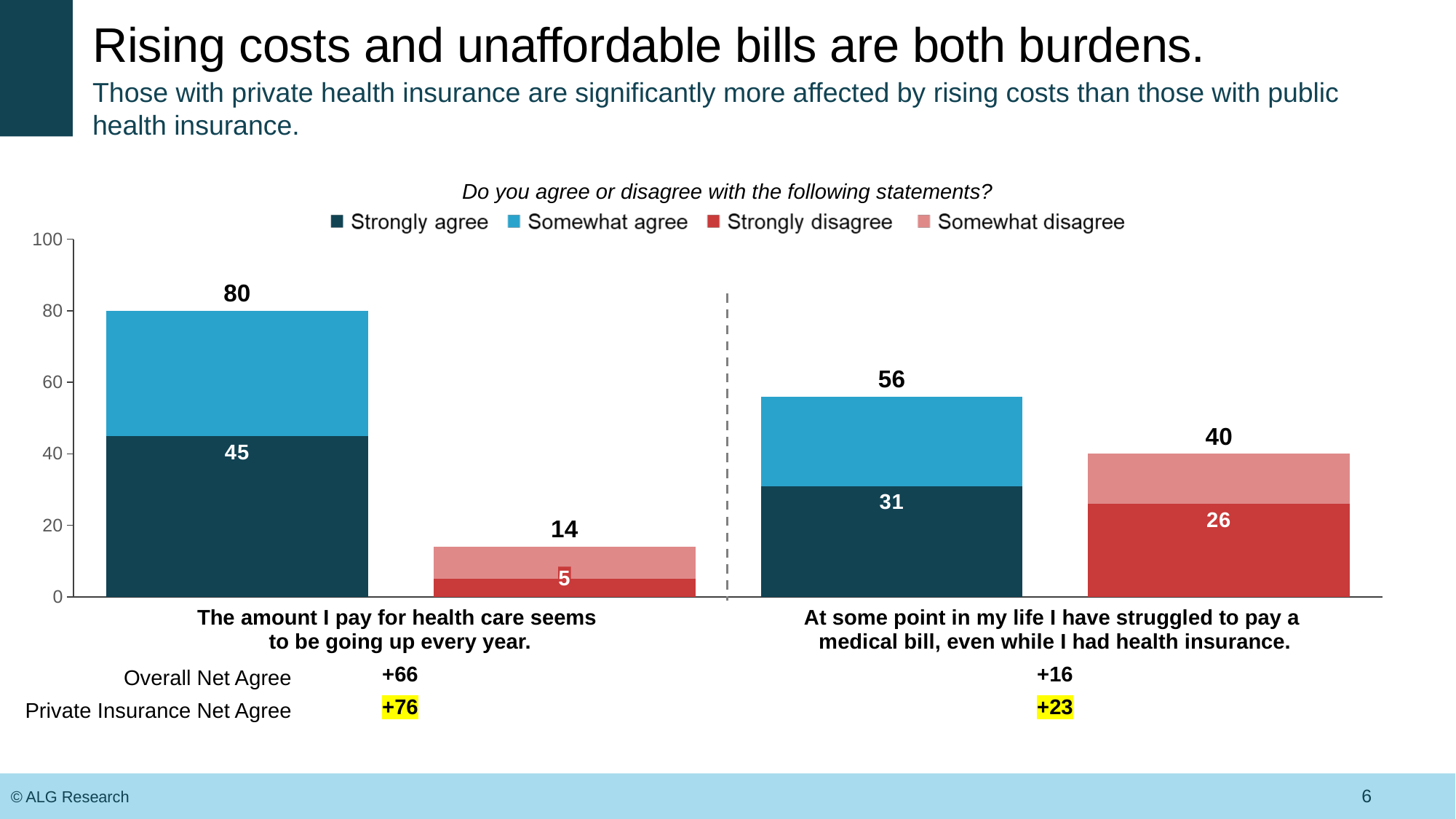
What is the Strongly agree value for the statement "The amount I pay for health care seems to be going up every year"? 45 Is the total agree value for the statement about struggling to pay a medical bill greater or less than 60? less How many series does the legend list? 4 What kind of chart is shown on the slide? Stacked bar chart What is the Strongly disagree value for the statement "At some point in my life I have struggled to pay a medical bill, even while I had health insurance"? 26 What is the total disagree value for the statement "The amount I pay for health care seems to be going up every year"? 14 What is the difference between the total agree (80) and total disagree (14) for the statement about health care costs going up every year? 66 Which statement has the higher total agree value? The amount I pay for health care seems to be going up every year. What is the total agree value for the statement "The amount I pay for health care seems to be going up every year"? 80 What is the Private Insurance Net Agree value shown for the statement about struggling to pay a medical bill? +23 Which is larger: the total disagree for the medical bill statement or the total disagree for the rising costs statement? The medical bill statement (40) What is the Strongly agree value for the statement "At some point in my life I have struggled to pay a medical bill, even while I had health insurance"? 31